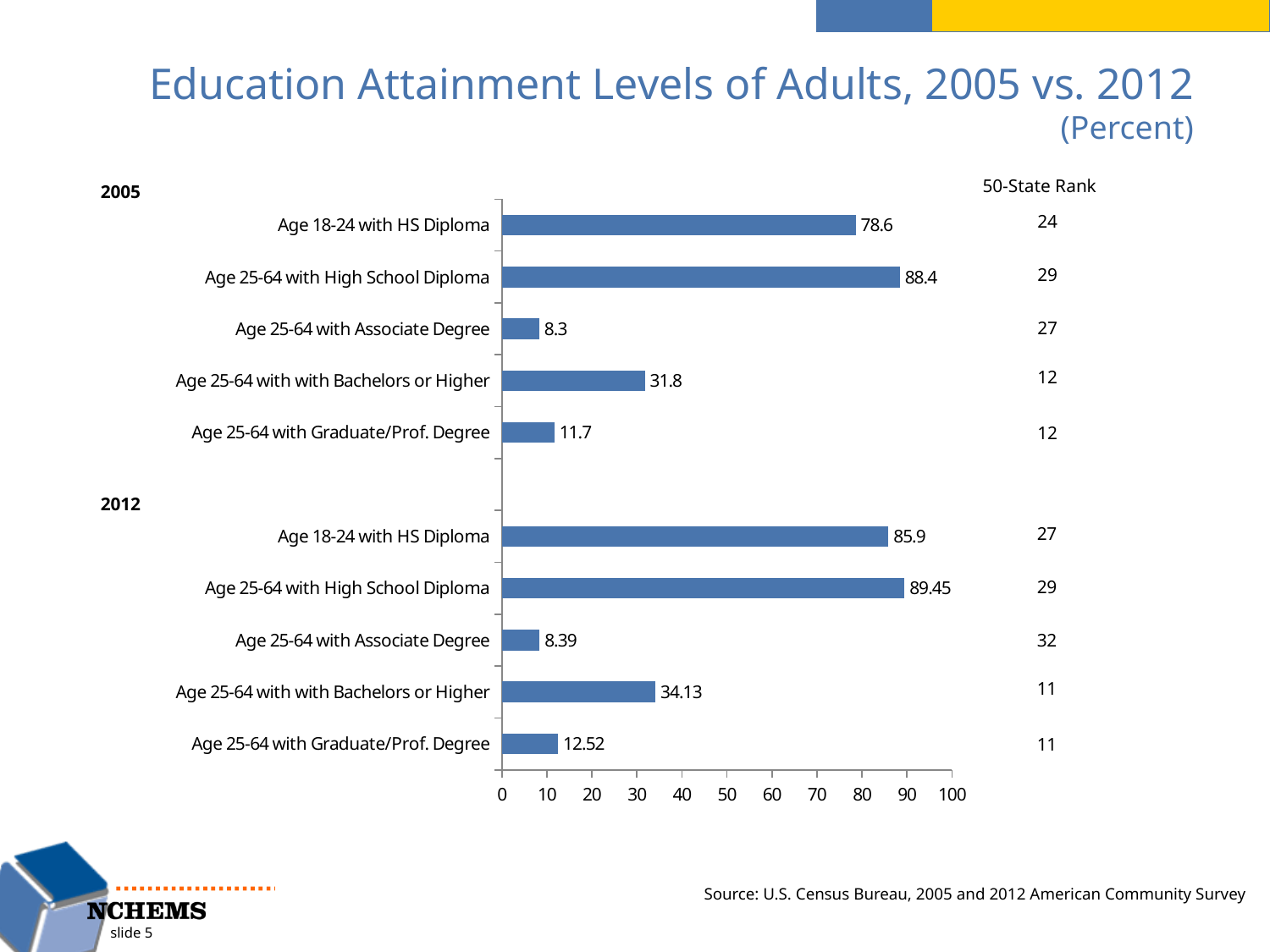
What is the value for Age 25-64 with High School Diploma in 2005? 88.4 How much higher is the value for Age 18-24 with HS Diploma in 2012 than in 2005? 7.3 Which category has the lowest value in the 2012 group? Age 25-64 with Associate Degree What is the value for Age 25-64 with Graduate/Prof. Degree in 2005? 11.7 What is the 50-State Rank shown for Age 25-64 with Associate Degree in 2012? 32 How many bars are plotted in the chart in total across both years? 10 Which category has the highest value in the 2005 group? Age 25-64 with High School Diploma Which is larger: the 2005 value for Age 25-64 with Associate Degree or the 2005 value for Age 25-64 with Graduate/Prof. Degree? Age 25-64 with Graduate/Prof. Degree What is the value for Age 25-64 with with Bachelors or Higher in 2012? 34.13 What is the value for Age 18-24 with HS Diploma in 2012? 85.9 What kind of chart is shown on the slide? Bar chart What is the difference between the 2012 and 2005 values for Age 25-64 with with Bachelors or Higher? 2.33